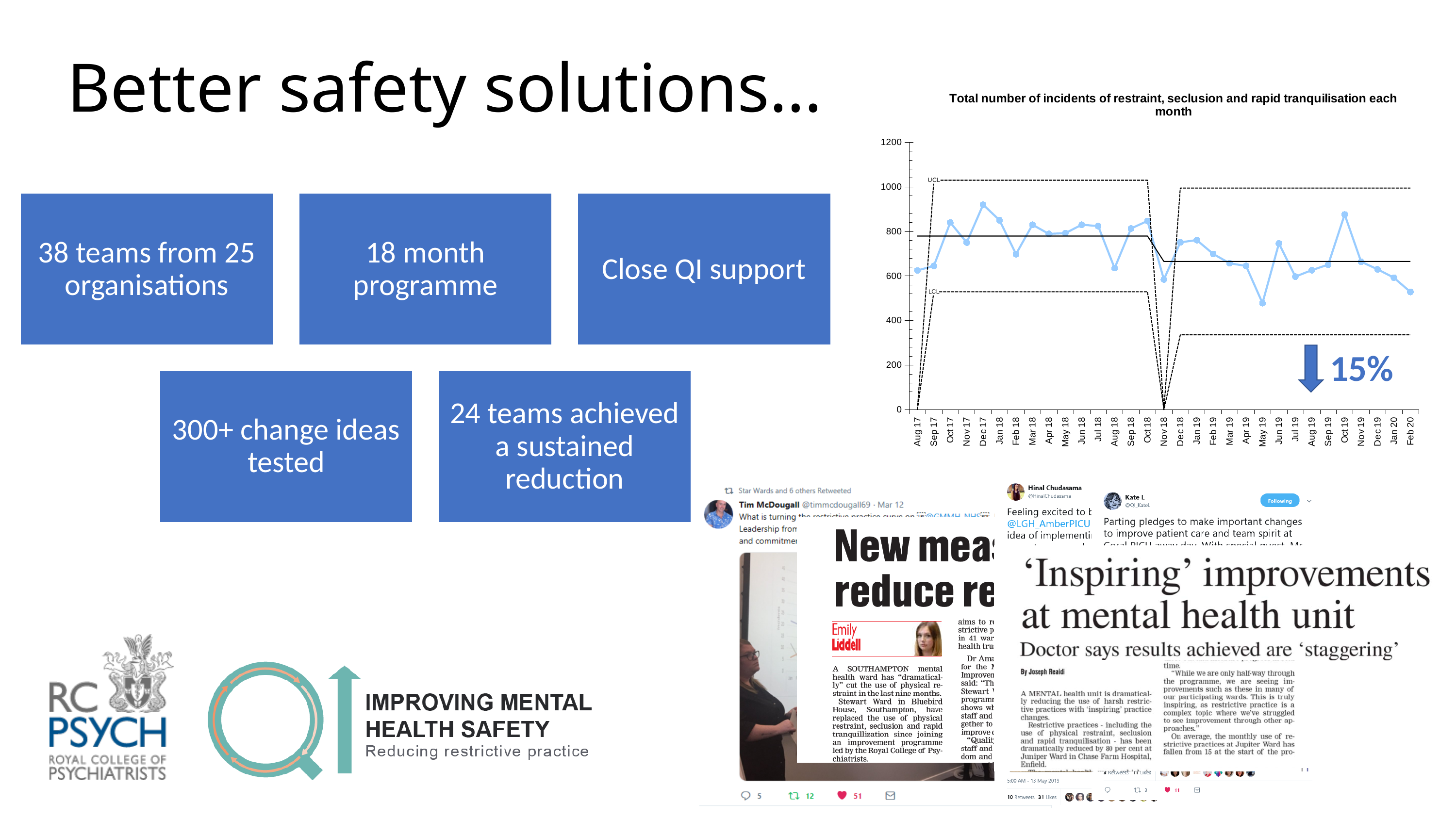
Which month has the highest number of incidents on the chart? Dec 17 Which month has the lowest number of incidents on the chart? May 19 How many monthly data points are plotted on the chart, from Aug 17 to Feb 20? 31 What is the title of the chart? Total number of incidents of restraint, seclusion and rapid tranquilisation each month Is the value for Dec 17 greater or less than 800? greater Is the value for Aug 17 greater or less than 800? less Is the value for May 19 greater or less than 600? less What percentage reduction is annotated next to the downward arrow on the chart? 15% Which is larger, the value for Dec 17 or the value for Feb 20? Dec 17 What kind of chart is shown on the slide? line chart Do the incident values generally rise or fall from Aug 17 to Feb 20? fall